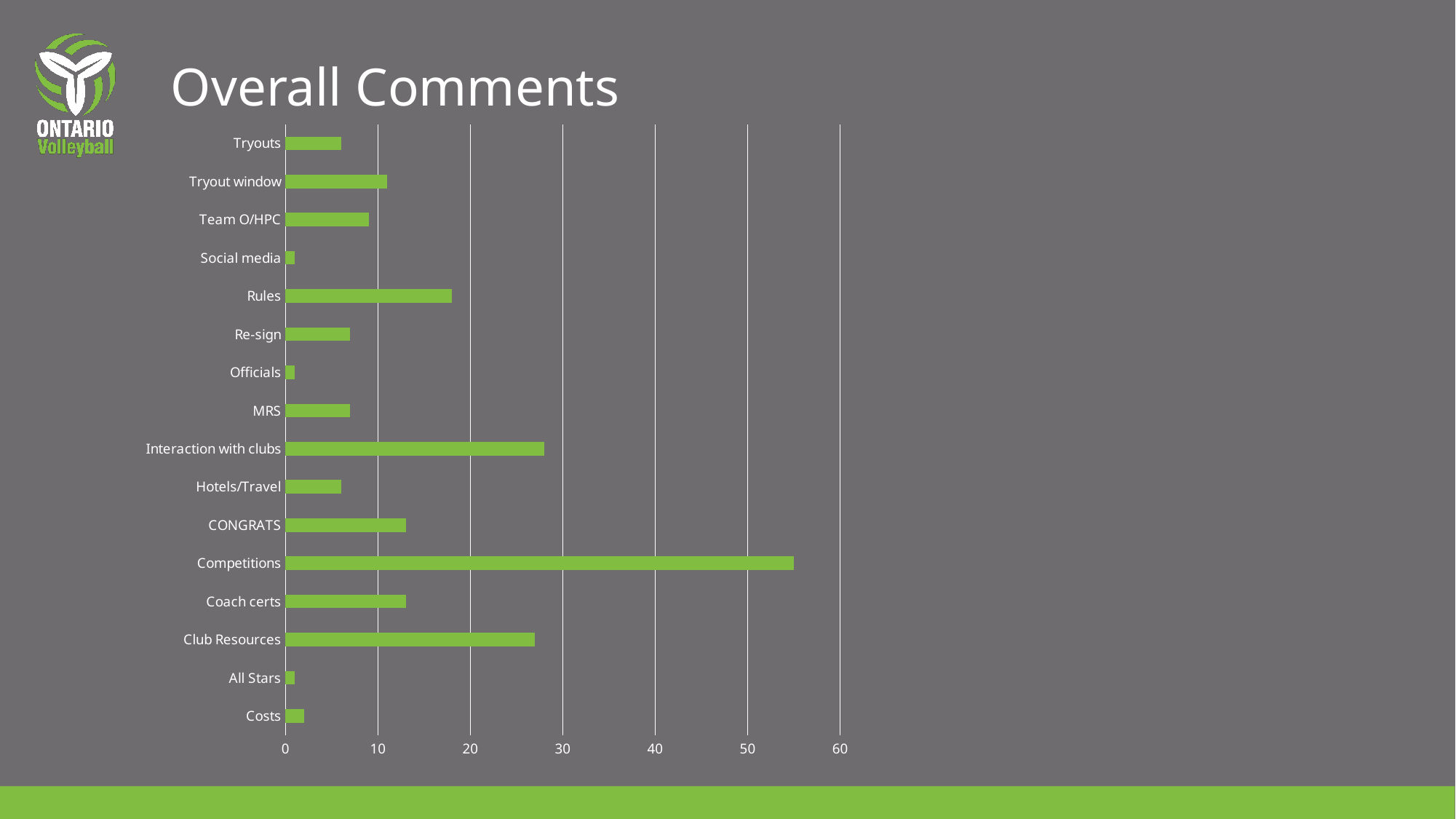
How many categories are plotted in the chart? 16 Is the value for Club Resources greater or less than 30? less Which is larger, the value for Competitions or the value for Club Resources? Competitions Is the value for Competitions greater or less than 50? greater Is the value for Interaction with clubs greater or less than 20? greater What is the title of the chart? Overall Comments What colour are the bars in the chart? green Which category has the highest value? Competitions Which is larger, the value for Rules or the value for Tryouts? Rules What kind of chart is shown on the slide? bar chart